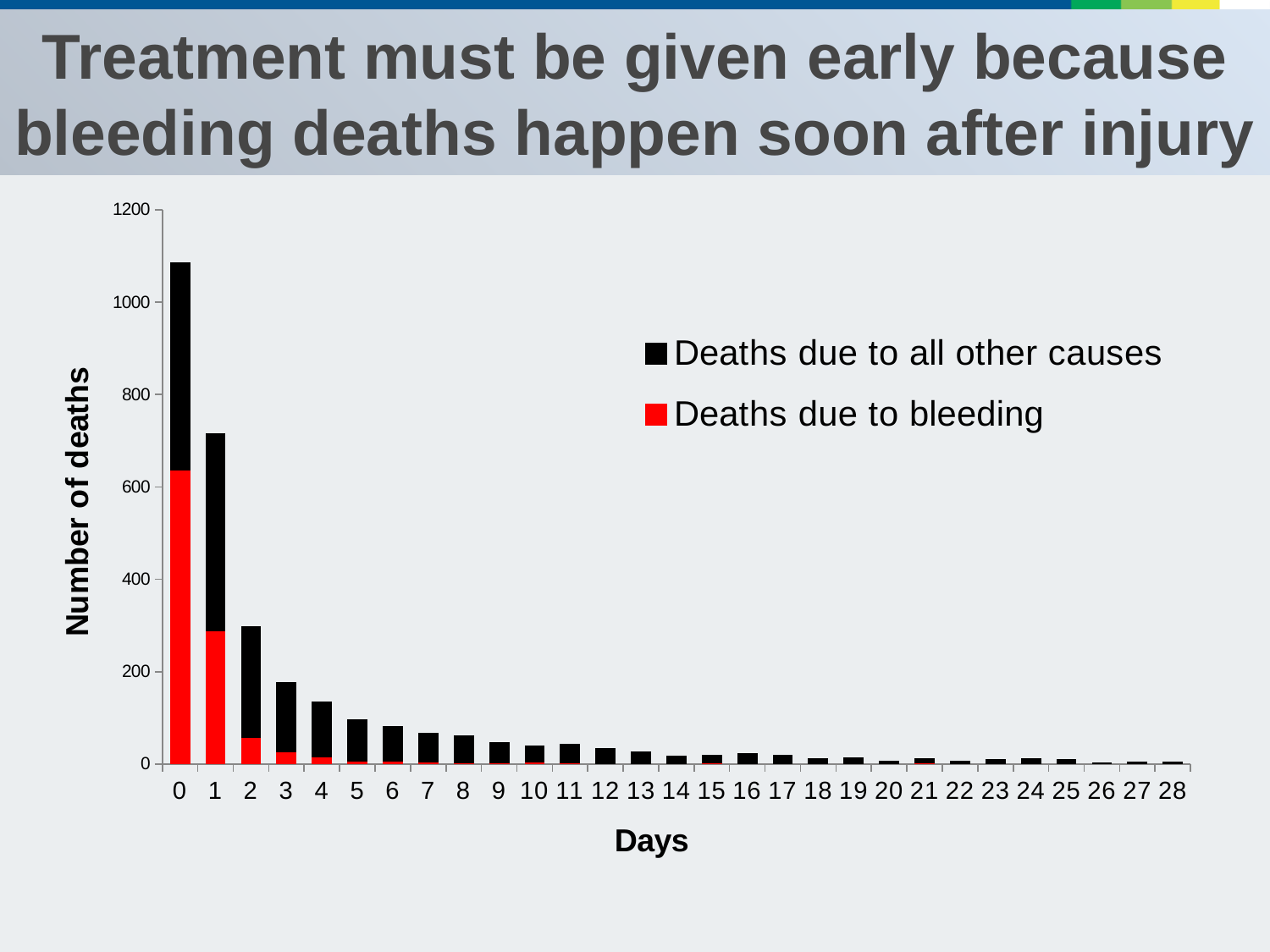
Is the total number of deaths on day 0 greater or less than 1000? greater Which colour represents deaths due to bleeding? Red Is the total number of deaths on day 3 greater or less than 200? less What kind of chart is shown on the slide? Stacked bar chart How many series does the legend list? 2 How many days (categories) are shown on the x axis? 29 Is the total number of deaths on day 1 greater or less than 800? less Do the total deaths rise or fall as the number of days increases? Fall Which day has the highest total number of deaths? 0 Which has more total deaths, day 0 or day 1? Day 0